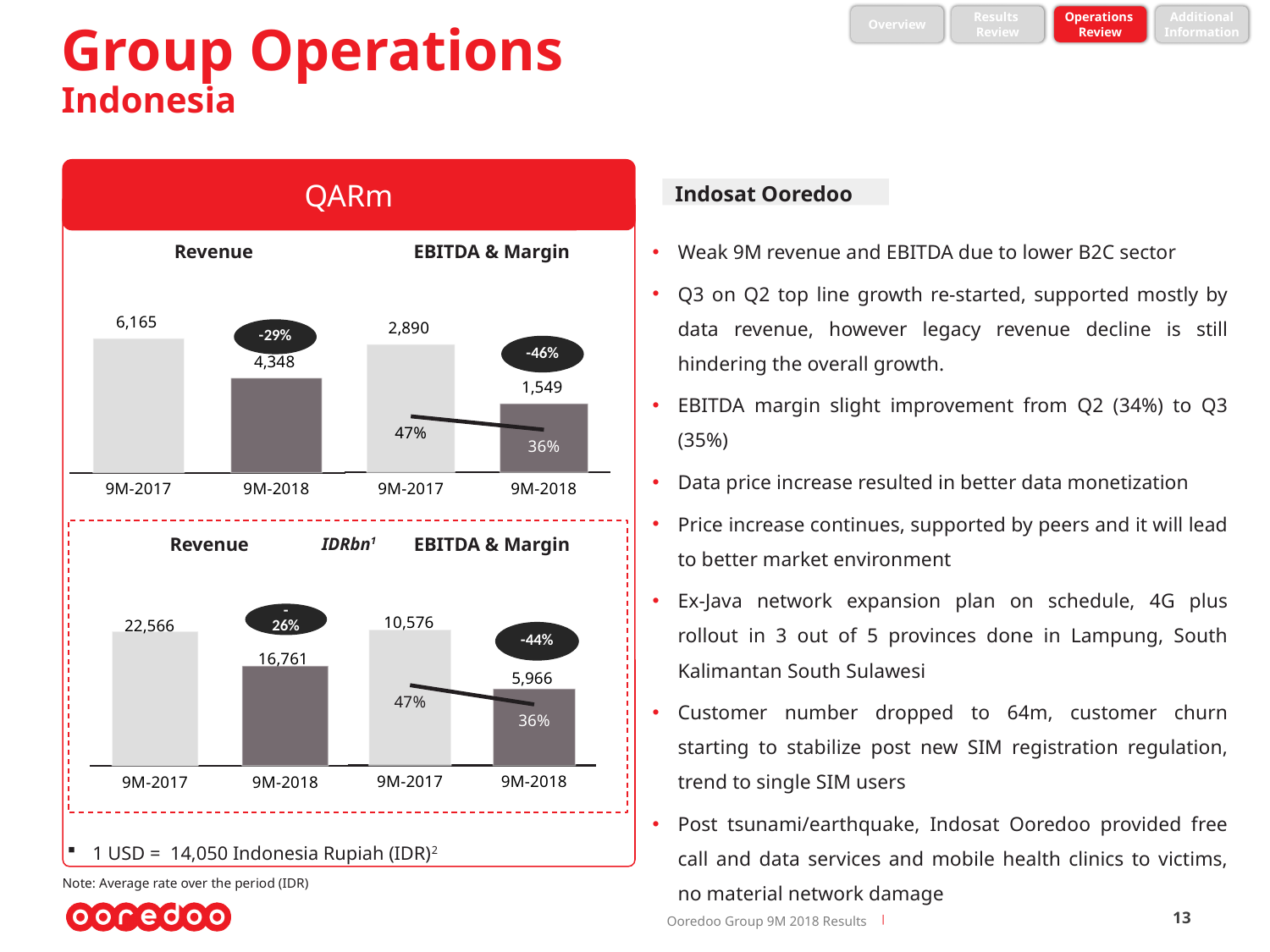
What type of chart is used for the IDRbn Revenue chart? Bar chart In the QARm Revenue chart, what is the revenue for 9M-2018? 4,348 In the QARm EBITDA & Margin chart, which period has the higher EBITDA, 9M-2017 or 9M-2018? 9M-2017 In the QARm Revenue chart, what is the difference between the 9M-2017 and 9M-2018 revenue values? 1,817 In the IDRbn EBITDA & Margin chart, what is the difference between the 9M-2017 and 9M-2018 EBITDA values? 4,610 In the QARm EBITDA & Margin chart, what is the EBITDA for 9M-2018? 1,549 In the QARm EBITDA & Margin chart, what is the EBITDA margin for 9M-2017? 47% In the QARm Revenue chart, what is the revenue for 9M-2017? 6,165 In the IDRbn EBITDA & Margin chart, what is the EBITDA for 9M-2017? 10,576 In the IDRbn Revenue chart, does revenue rise or fall from 9M-2017 to 9M-2018? Fall In the IDRbn Revenue chart, what is the revenue for 9M-2018? 16,761 What percentage change is shown in the oval on the QARm EBITDA & Margin chart? -46%